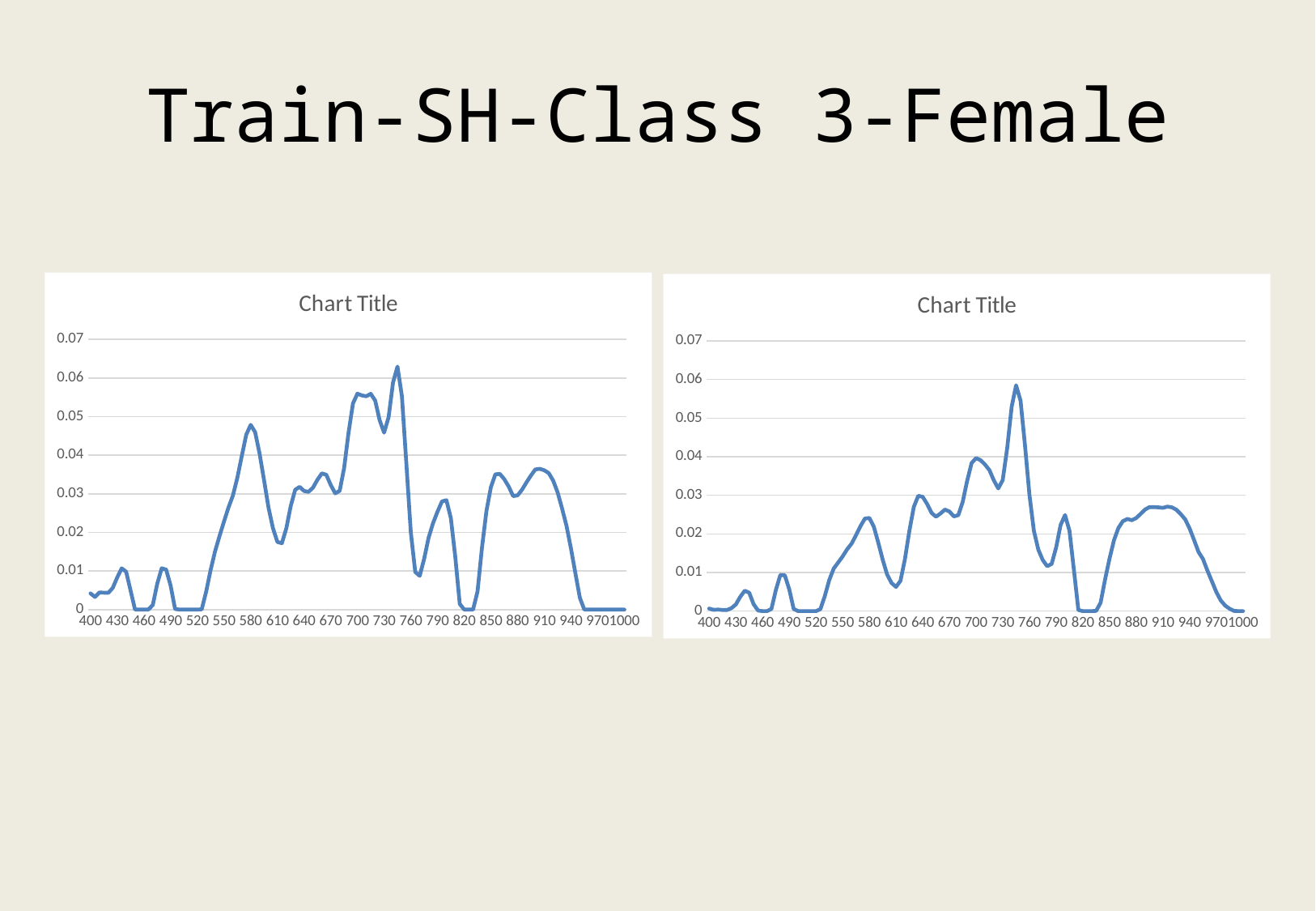
In the left chart, is the highest value on the line greater or less than 0.06? greater In the left chart, does the line rise or fall between 940 and 1000 on the x axis? fall In the right chart, is the value at 580 greater or less than 0.02? greater How many charts are shown on the slide? 2 In the left chart, is the value at 700 greater or less than 0.05? greater What kind of chart is the chart on the right of the slide? line chart What title is shown above the chart on the left of the slide? Chart Title What kind of chart is the chart on the left of the slide? line chart